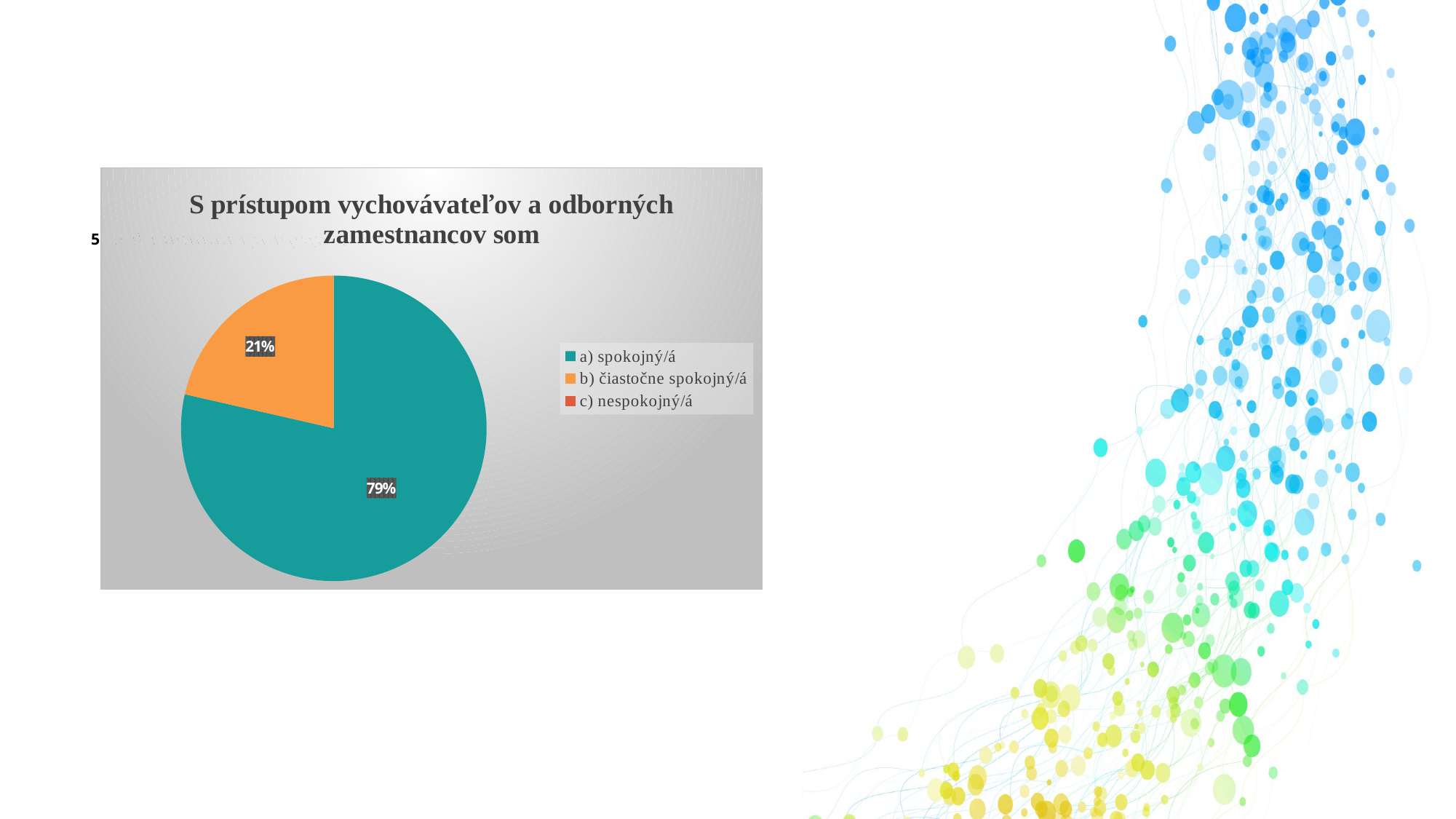
Which is larger, the slice for "a) spokojný/á" or the slice for "b) čiastočne spokojný/á"? a) spokojný/á What share of the pie does "b) čiastočne spokojný/á" take? 21% What is the title of the chart? S prístupom vychovávateľov a odborných zamestnancov som Is the share for "a) spokojný/á" greater or less than 50%? greater Is the share for "b) čiastočne spokojný/á" greater or less than 25%? less Which category has the largest slice of the pie? a) spokojný/á What share of the pie does "a) spokojný/á" take? 79% What colour is the slice for "b) čiastočne spokojný/á"? orange What is the difference in percentage points between the "a) spokojný/á" slice and the "b) čiastočne spokojný/á" slice? 58 How many entries does the legend list? 3 What kind of chart is shown on the slide? pie chart